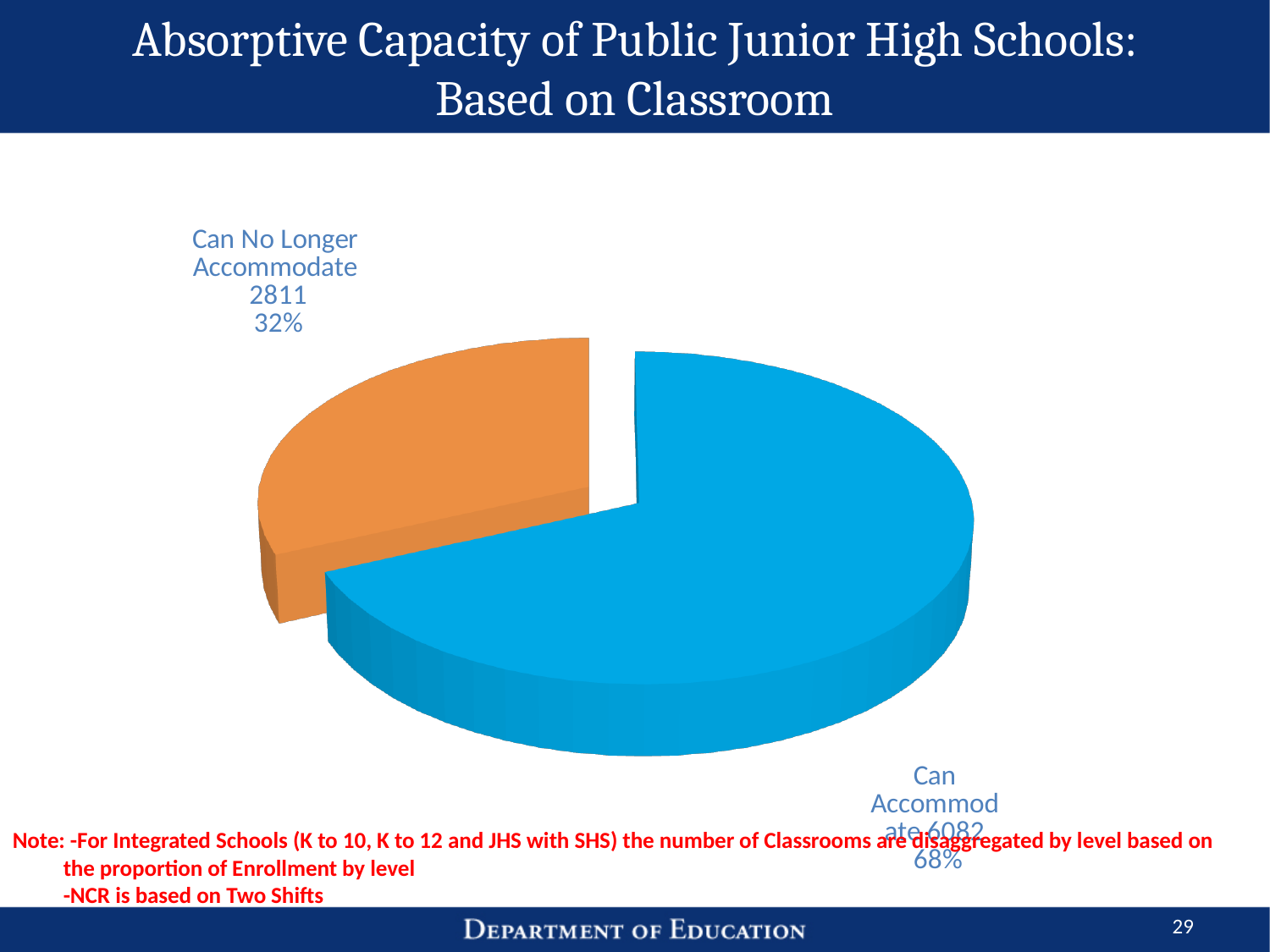
What is the value for the 'Can Accommodate' slice? 6082 Which is larger, the value for 'Can Accommodate' or the value for 'Can No Longer Accommodate'? Can Accommodate How many slices does the pie chart have? 2 What is the title of the chart on the slide? Absorptive Capacity of Public Junior High Schools: Based on Classroom What is the total of the two slice values in the pie chart? 8893 What kind of chart is shown on the slide? pie chart What share of the pie does the 'Can No Longer Accommodate' slice represent? 32% Which slice is the largest in the pie chart? Can Accommodate What is the value for the 'Can No Longer Accommodate' slice? 2811 What share of the pie does the 'Can Accommodate' slice represent? 68% What is the difference between the 'Can Accommodate' value and the 'Can No Longer Accommodate' value? 3271 Which slice is the smallest in the pie chart? Can No Longer Accommodate